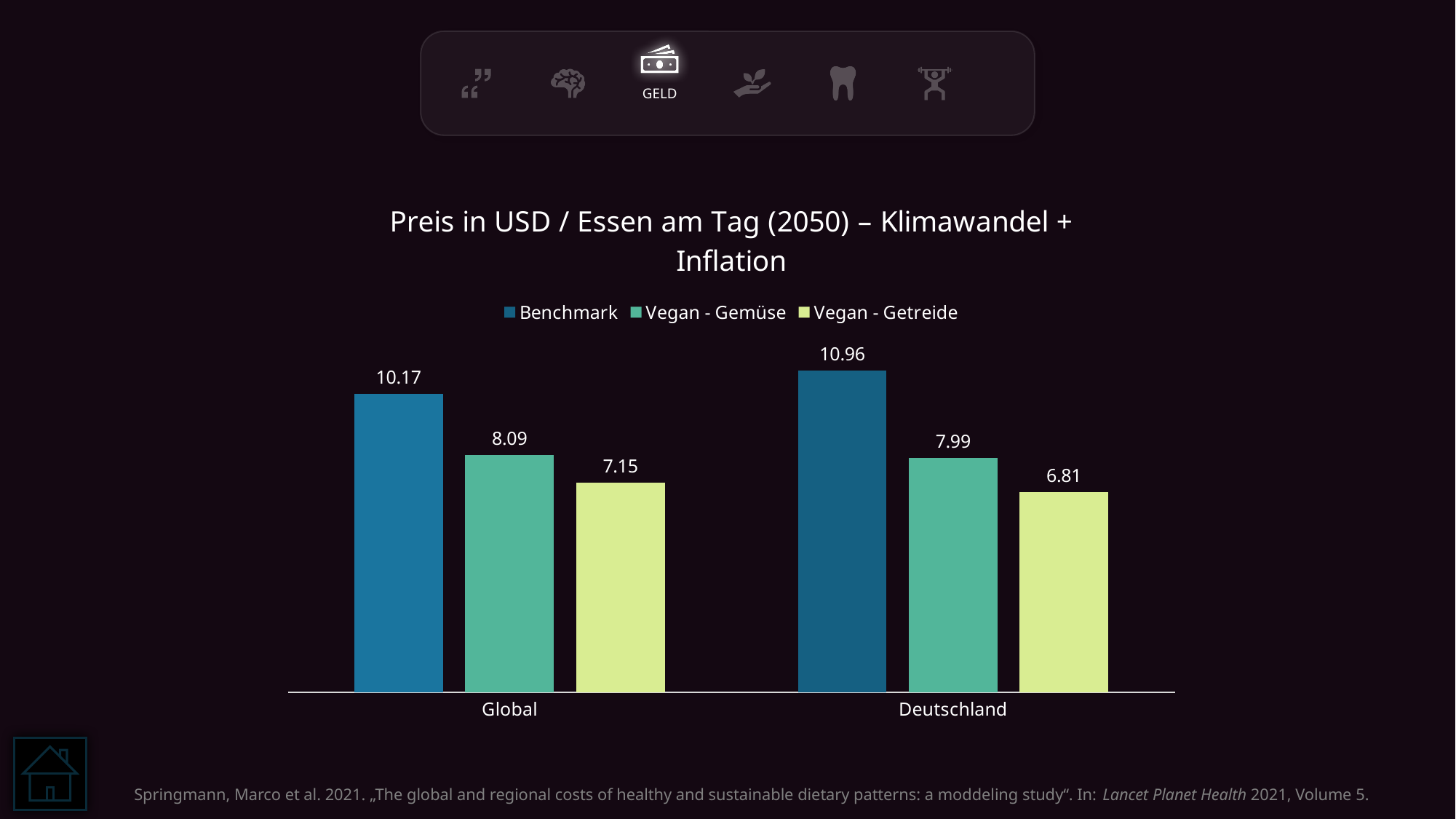
What is the Vegan - Gemüse value for Deutschland? 7.99 What is the title of the chart? Preis in USD / Essen am Tag (2050) – Klimawandel + Inflation Which series has the highest value for Deutschland? Benchmark What is the Benchmark value for Global? 10.17 How many series does the legend list? 3 What is the Benchmark value for Deutschland? 10.96 What kind of chart is shown on the slide? Bar chart Which series has the lowest value for Global? Vegan - Getreide How many categories are shown on the x axis? 2 Which is larger: the Vegan - Gemüse value for Global or for Deutschland? Global What is the Vegan - Getreide value for Global? 7.15 What is the difference between the Benchmark and Vegan - Getreide values for Deutschland? 4.15